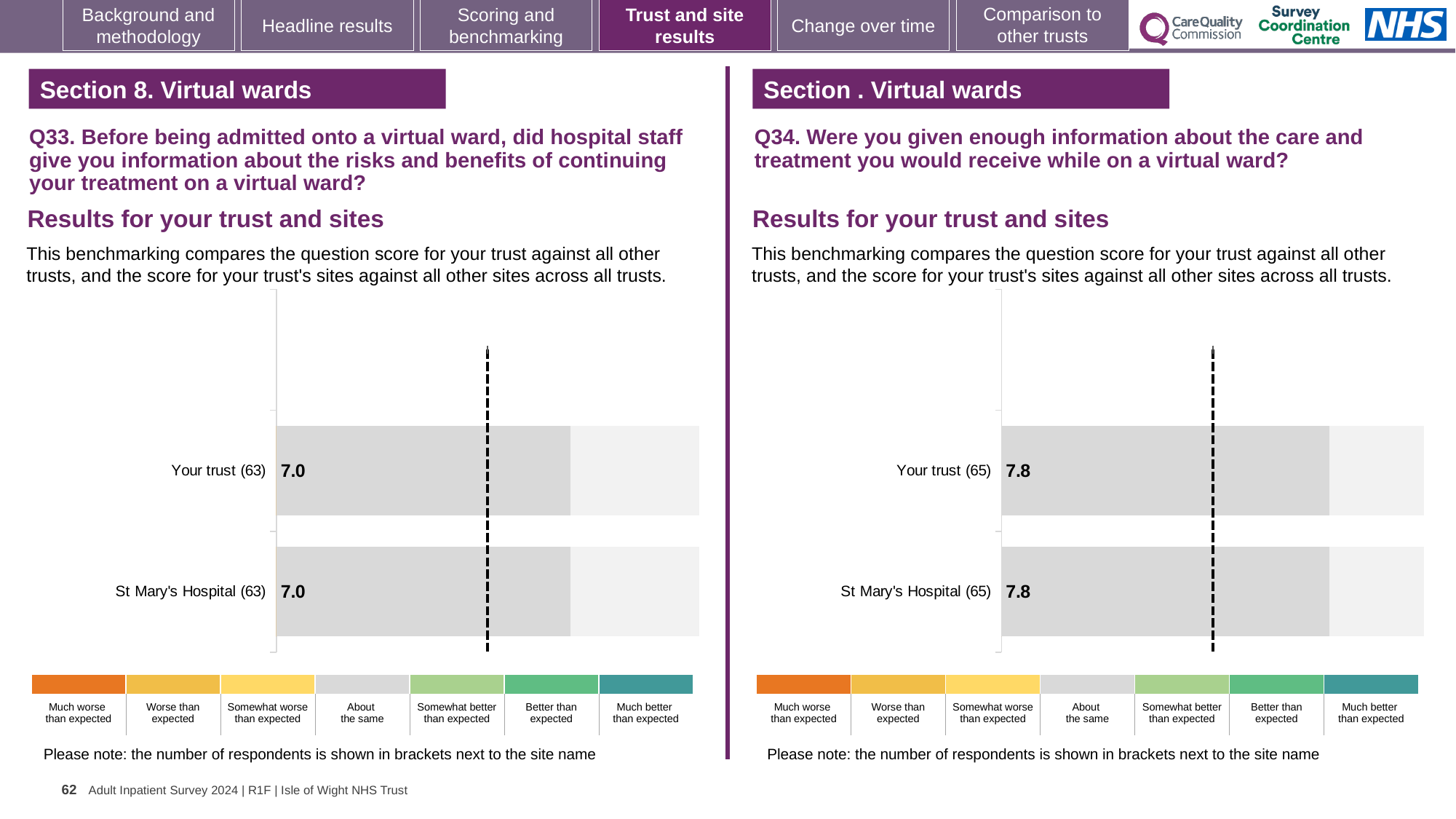
In the Q33 chart on the left, what is the score for Your trust? 7.0 In the Q34 chart on the right, what is the score for St Mary's Hospital? 7.8 How many bars are plotted in the Q33 chart on the left? 2 In the Q33 chart on the left, what is the difference between the Your trust score and the St Mary's Hospital score? 0.0 How many benchmark categories are shown in the colour key below the Q33 chart on the left? 7 What is the difference between the Your trust score in the Q34 chart and the Your trust score in the Q33 chart? 0.8 In the Q34 chart on the right, what is the score for Your trust? 7.8 What kind of chart is used for the Q34 results on the right? Bar chart In the Q34 chart on the right, how many respondents are shown in brackets next to Your trust? 65 In the Q33 chart on the left, what is the score for St Mary's Hospital? 7.0 Which is larger: the Your trust score in the Q33 chart or the Your trust score in the Q34 chart? Q34